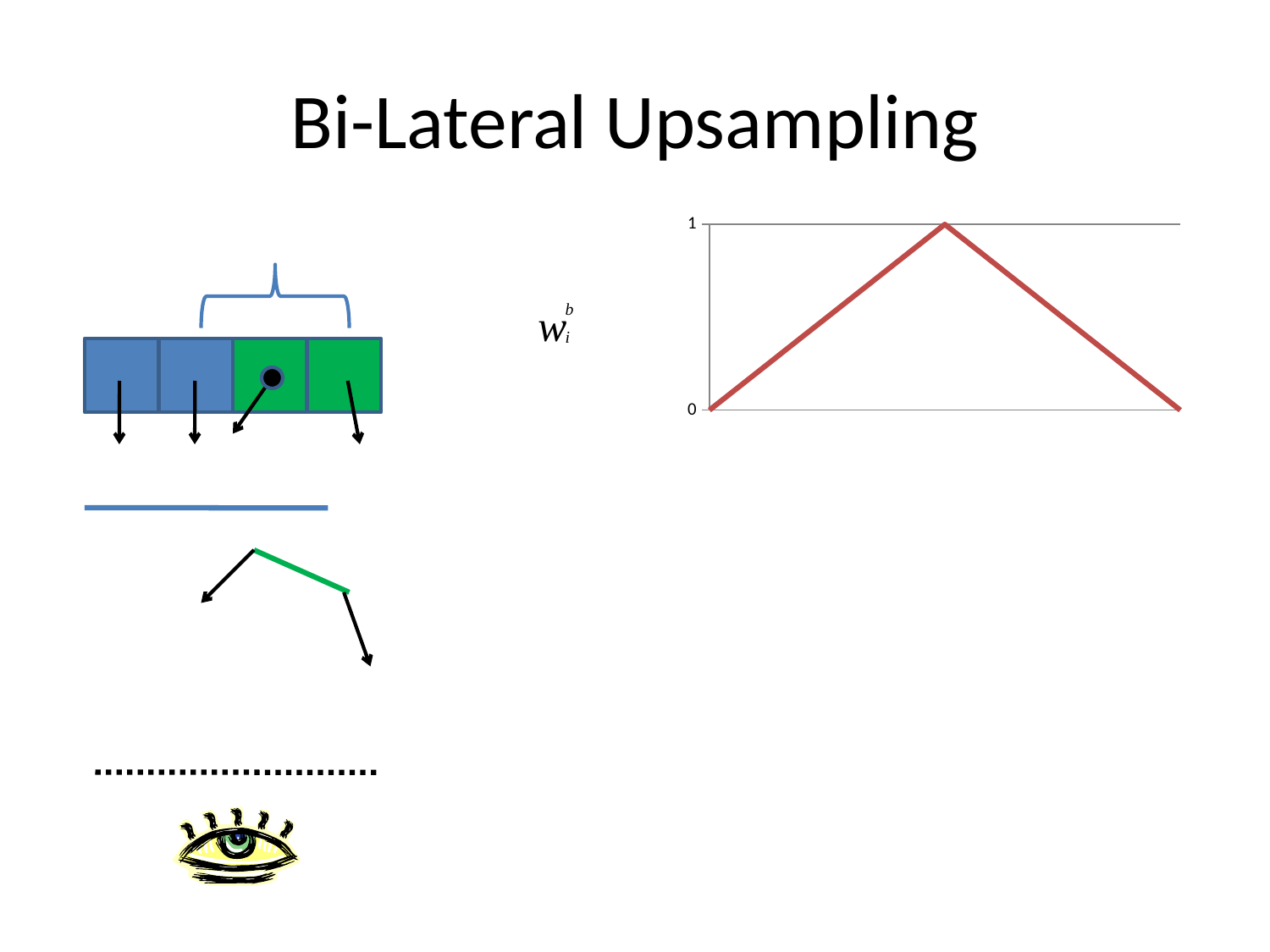
What is the difference between the peak value of the line and its value at the right endpoint? 1 What is the lowest value reached by the line in the chart? 0 What is the value of the line at its left endpoint? 0 What is the value of the line at its right endpoint? 0 What is the highest value reached by the line in the chart? 1 How does the line behave moving from left to right along the x axis? rises to a peak, then falls What kind of chart is shown on the right side of the slide? line chart What is the value of the line at its peak in the middle? 1 What colour is the plotted line in the chart? red What are the two tick values labelled on the y axis of the chart? 0 and 1 Is the value at the peak of the line larger or smaller than the value at the left endpoint? larger